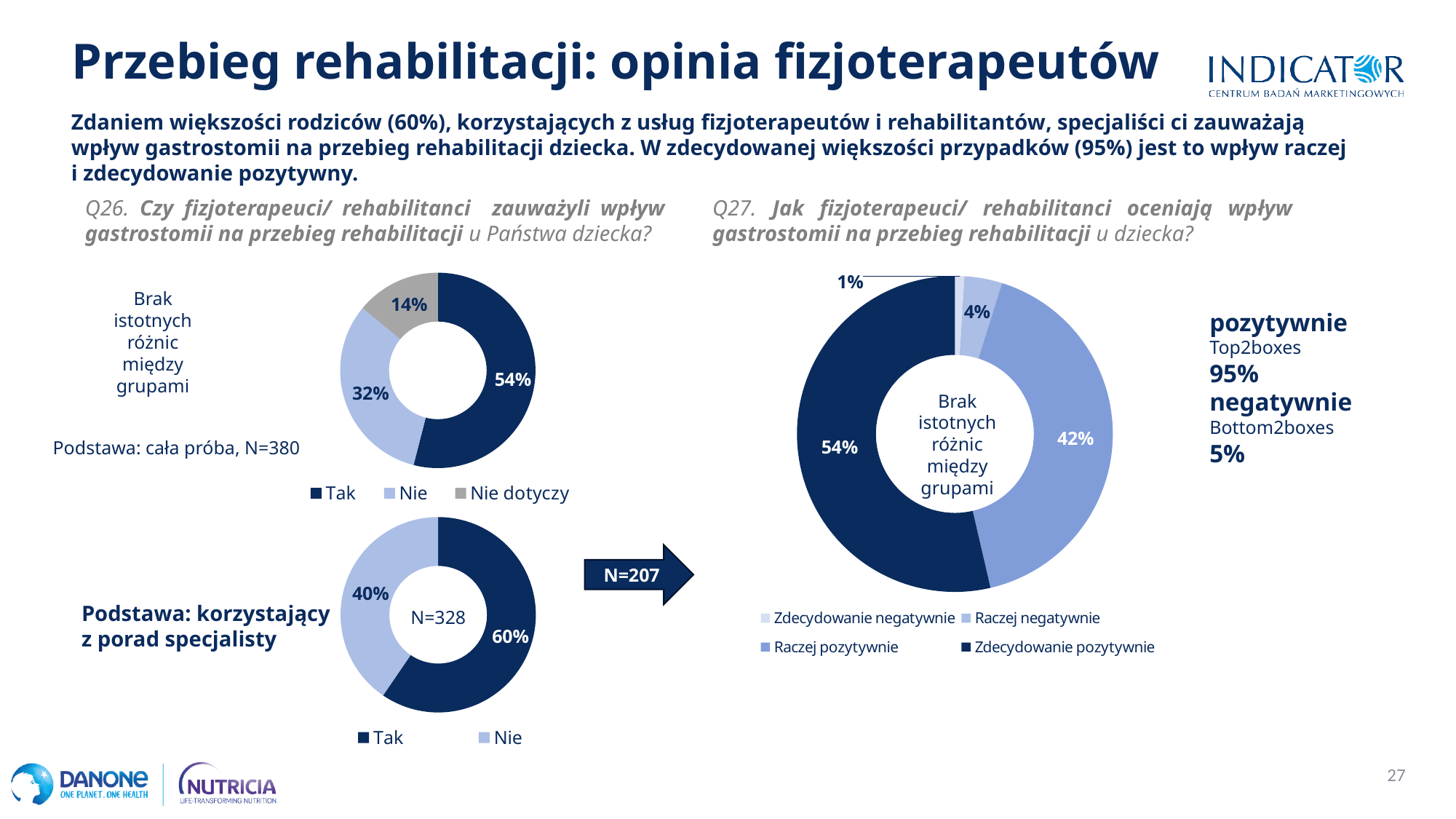
What sample size (N) is shown in the arrow pointing to the right-hand donut chart (Q27)? N=207 In the top-left donut chart (Q26, N=380), what percentage is shown for "Tak"? 54% In the right-hand donut chart (Q27), what is the combined share of "Zdecydowanie negatywnie" and "Raczej negatywnie"? 5% What type of chart is used for the bottom-left chart (N=328)? Donut (pie) chart In the top-left donut chart (Q26, N=380), what percentage is shown for "Nie dotyczy"? 14% How many categories does the legend of the top-left donut chart (Q26, N=380) list? 3 In the top-left donut chart (Q26, N=380), which category has the smallest share? Nie dotyczy In the right-hand donut chart (Q27), which category has the largest share? Zdecydowanie pozytywnie In the bottom-left donut chart (N=328), what percentage is shown for "Nie"? 40% In the bottom-left donut chart (N=328), which is larger, "Tak" or "Nie"? Tak In the right-hand donut chart (Q27), what percentage is shown for "Raczej pozytywnie"? 42% In the top-left donut chart (Q26, N=380), what is the difference between the "Tak" and "Nie" shares? 22%